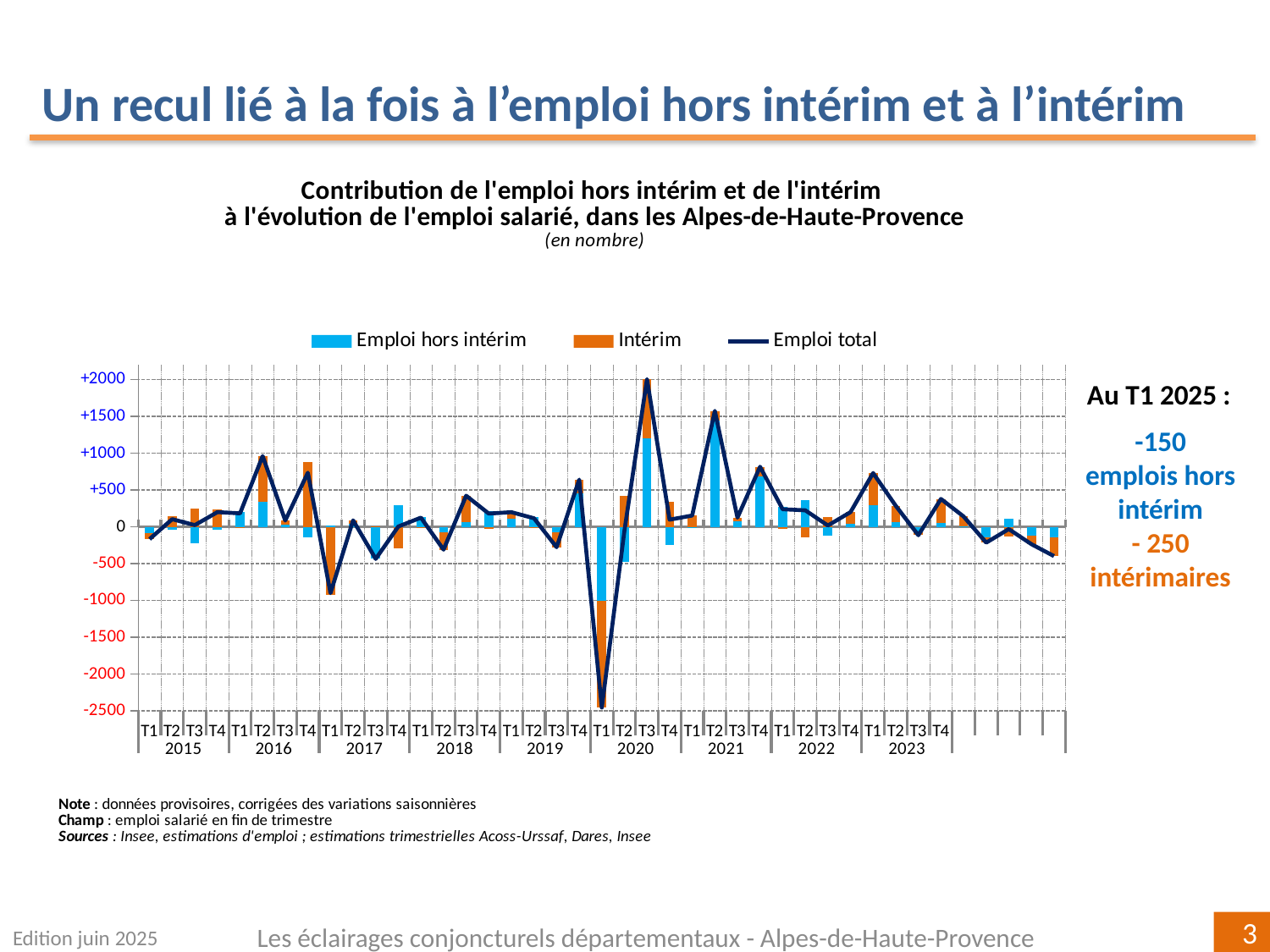
Is the Emploi total value at T1 2017 greater or less than -500? less How many series does the legend list? 3 Using the T1 2025 figures printed on the slide, what is the total change in employment (Emploi total) at T1 2025? -400 Which series is drawn as a line rather than bars? Emploi total What kind of chart is shown on the slide? Combined bar and line chart Which is larger, the Emploi total value at T3 2020 or at T2 2021? T3 2020 What is the value for Emploi hors intérim at T1 2025, as stated on the slide? -150 Is the Emploi total value at T2 2021 greater or less than +1000? greater What is the value for Intérim at T1 2025, as stated on the slide? -250 In which quarter does the Emploi total line reach its highest point? T3 2020 In which quarter does the Emploi total line reach its lowest point? T1 2020 Is the Emploi total value at T1 2020 greater or less than -2000? less